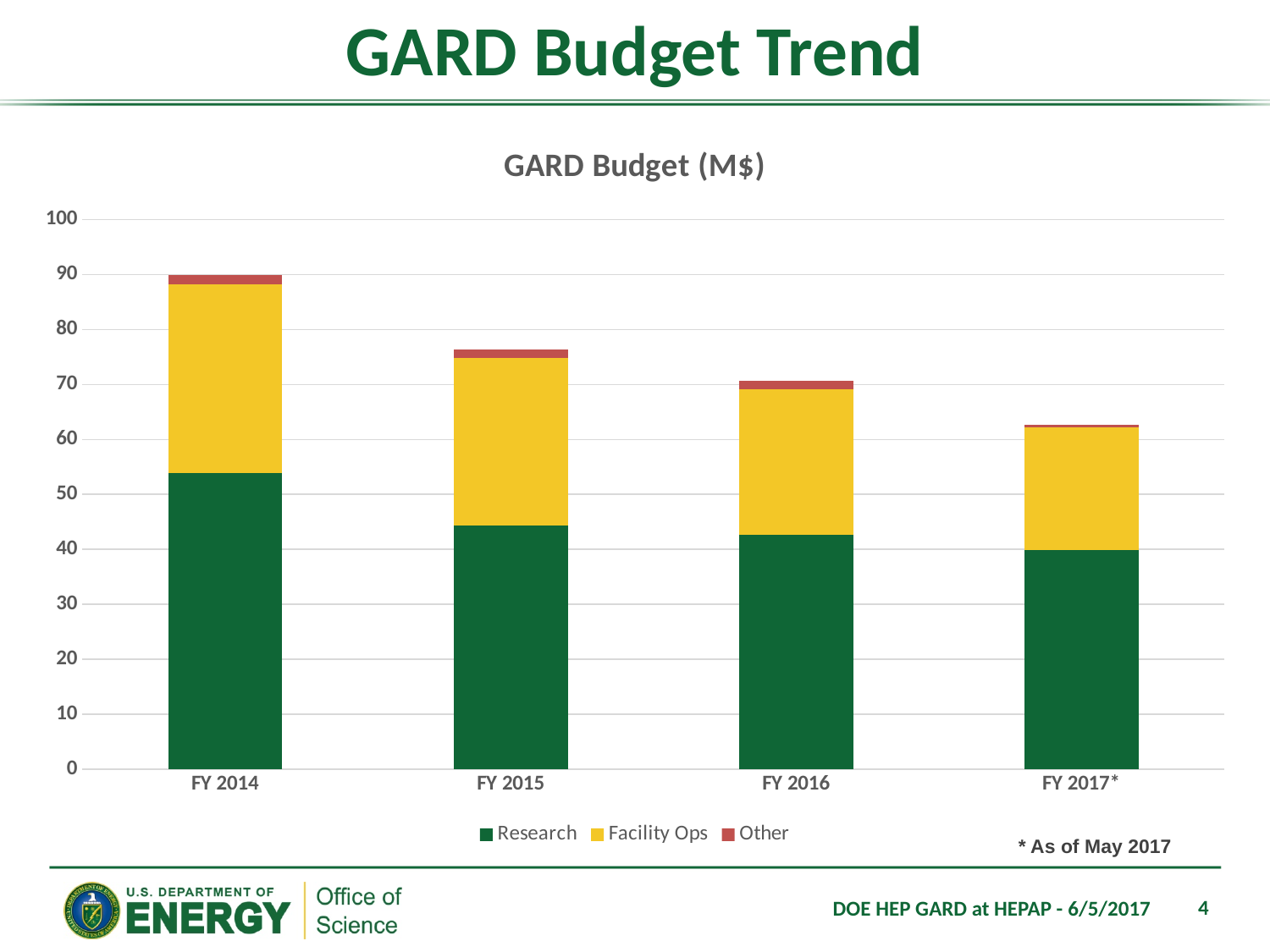
Which series is shown in green in the chart? Research Which fiscal year has the highest total GARD budget bar? FY 2014 Which fiscal year has the lowest total GARD budget bar? FY 2017* What kind of chart is shown on the slide? Stacked bar chart Is the total bar for FY 2014 greater or less than 80? greater How many series does the chart's legend list? 3 Is the total bar for FY 2017* greater or less than 70? less Do the total GARD budget bars rise or fall from FY 2014 to FY 2017*? Fall How many fiscal years are shown on the x axis of the chart? 4 What is the title of the chart? GARD Budget (M$) Which is larger, the Research value for FY 2014 or the Research value for FY 2015? FY 2014 Is the Research value for FY 2014 greater or less than 50? greater